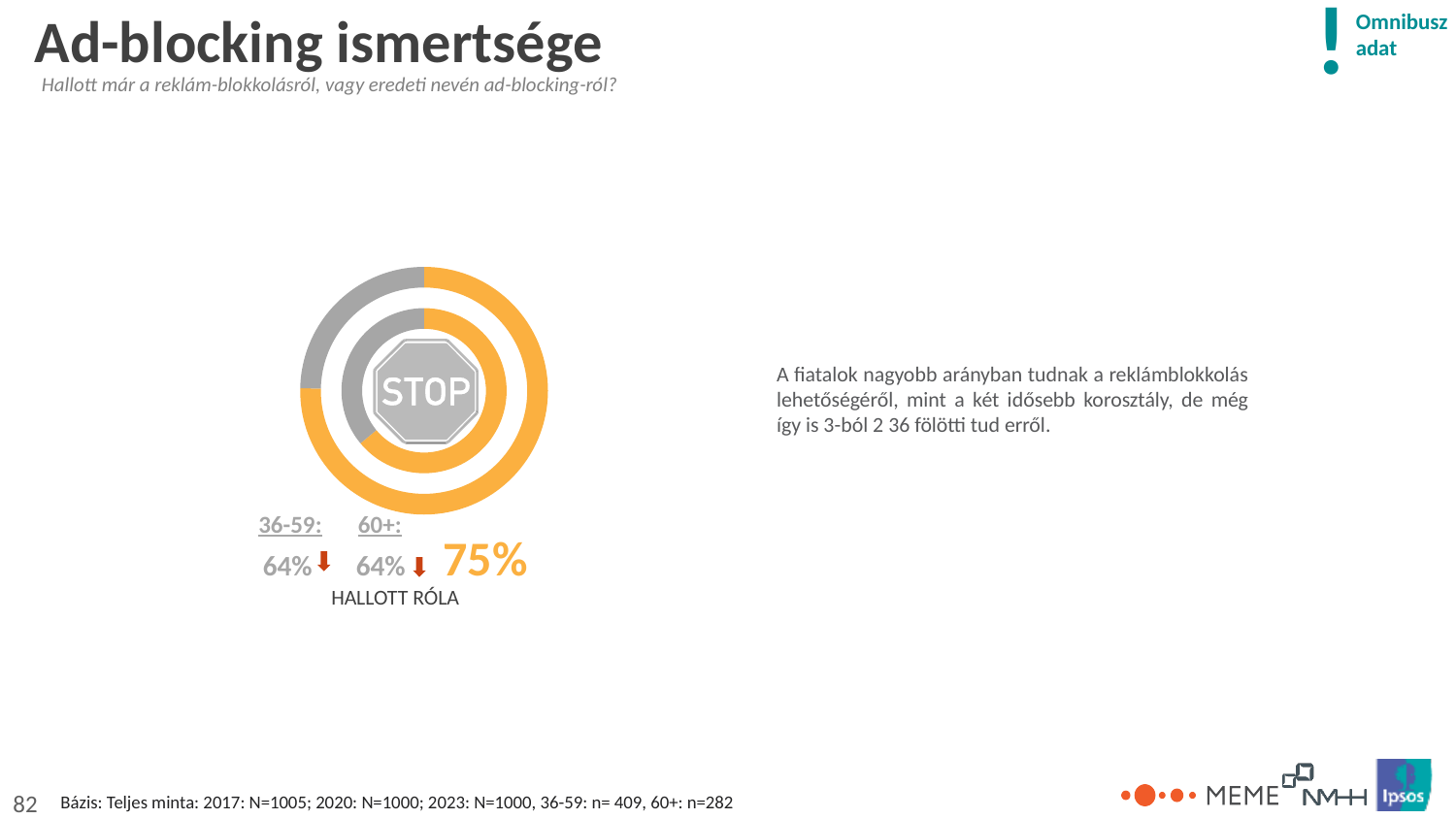
What is the difference in percentage points between the 75% value and the 64% value for the 60+ group? 11 percentage points How many concentric rings does the doughnut chart have? 3 What label appears directly beneath the percentage values under the chart? HALLOTT RÓLA What is the title of the slide containing the chart? Ad-blocking ismertsége What is the large orange percentage shown next to the age-group values under the chart? 75% What percentage of the 36-59 age group has heard of ad-blocking according to the chart? 64% What is the lowest percentage value shown on the chart? 64% What is the highest percentage value shown on the chart? 75% How many age groups are labelled under the chart? 2 Is the value for the 36-59 group greater than, less than, or equal to the value for the 60+ group? equal What kind of chart is shown on the slide? doughnut chart What percentage of the 60+ age group has heard of ad-blocking according to the chart? 64%